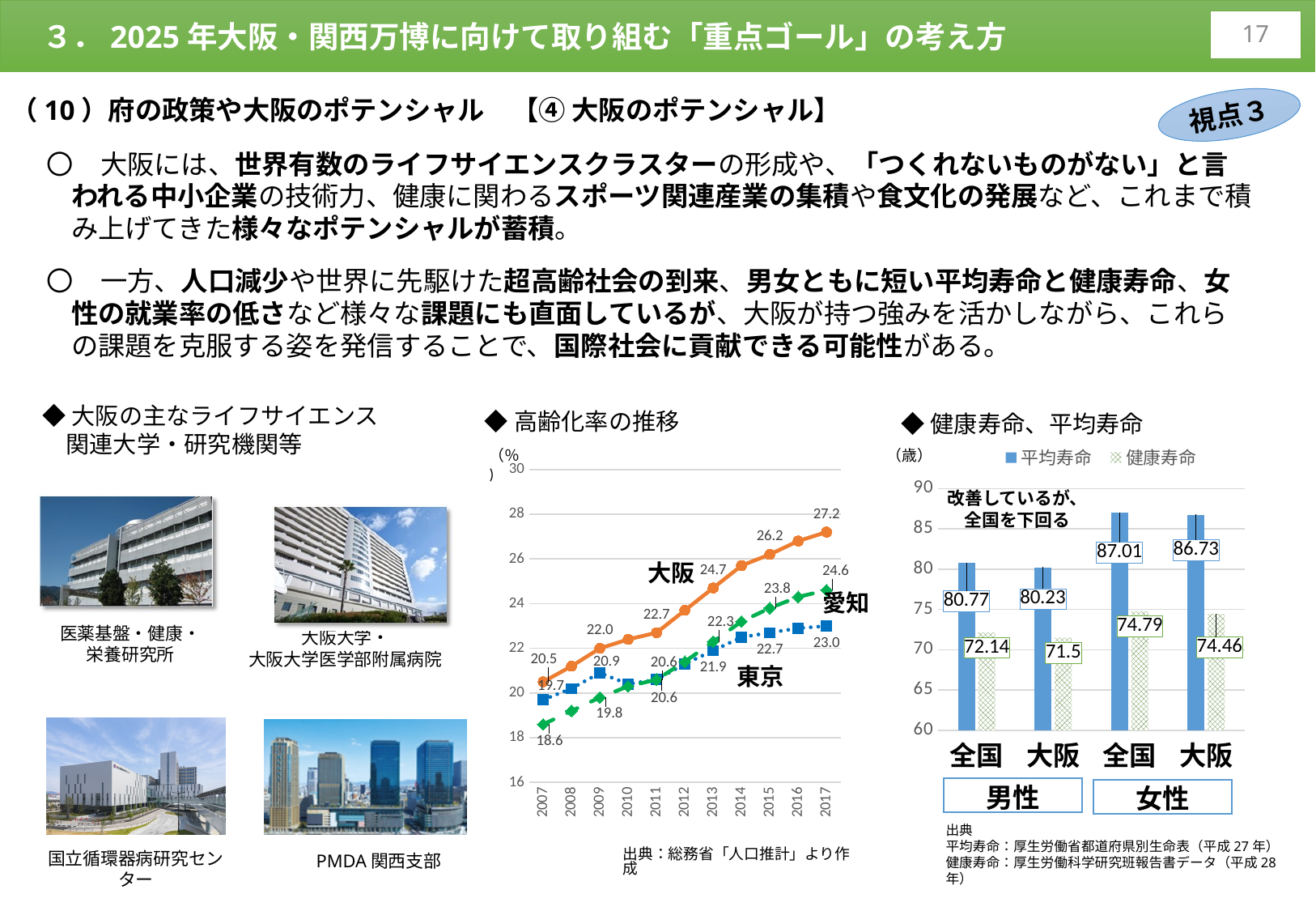
In the 高齢化率の推移 chart, what is the difference between 大阪 and 東京 in 2017? 4.2 In the 健康寿命、平均寿命 chart, what is the 平均寿命 for 大阪 men (男性)? 80.23 In the 高齢化率の推移 chart, does the value for 大阪 rise or fall from 2007 to 2017? rise How many series does the legend of the 健康寿命、平均寿命 chart list? 2 In the 健康寿命、平均寿命 chart, what is the 健康寿命 for 全国 women (女性)? 74.79 In the 高齢化率の推移 chart, how many years are shown on the x axis? 11 In the 高齢化率の推移 chart, which of the three regions has the highest value in 2017? 大阪 What kind of chart is the 高齢化率の推移 chart? line chart In the 健康寿命、平均寿命 chart, which is larger, the 平均寿命 for 全国 women or for 大阪 women? 全国 In the 高齢化率の推移 chart, what is the value for 大阪 in 2017? 27.2 In the 高齢化率の推移 chart, what is the value for 東京 in 2017? 23.0 In the 高齢化率の推移 chart, what is the value for 愛知 in 2007? 18.6